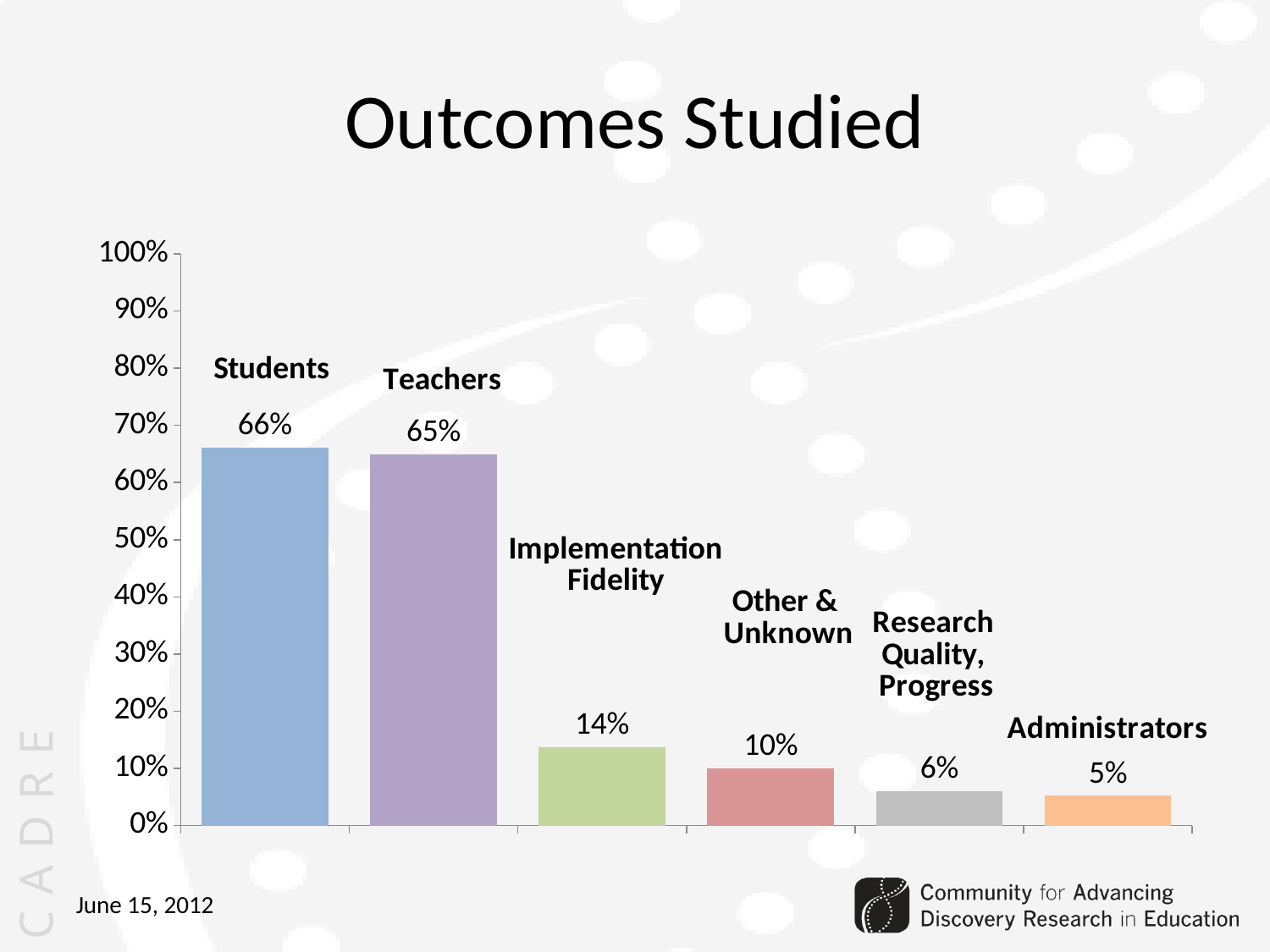
What type of chart is shown on the slide? Bar chart Which outcome category has the lowest value? Administrators Which outcome category has the highest value? Students What percentage of studies examined Students as an outcome? 66% What is the difference between the Students and Teachers values? 1% What is the value shown for Research Quality, Progress? 6% What is the difference between the Implementation Fidelity and Other & Unknown values? 4% What is the value shown for Implementation Fidelity? 14% What is the value shown for Administrators? 5% What is the title of the slide? Outcomes Studied How many outcome categories are shown in the chart? 6 Which is larger, the value for Other & Unknown or the value for Research Quality, Progress? Other & Unknown